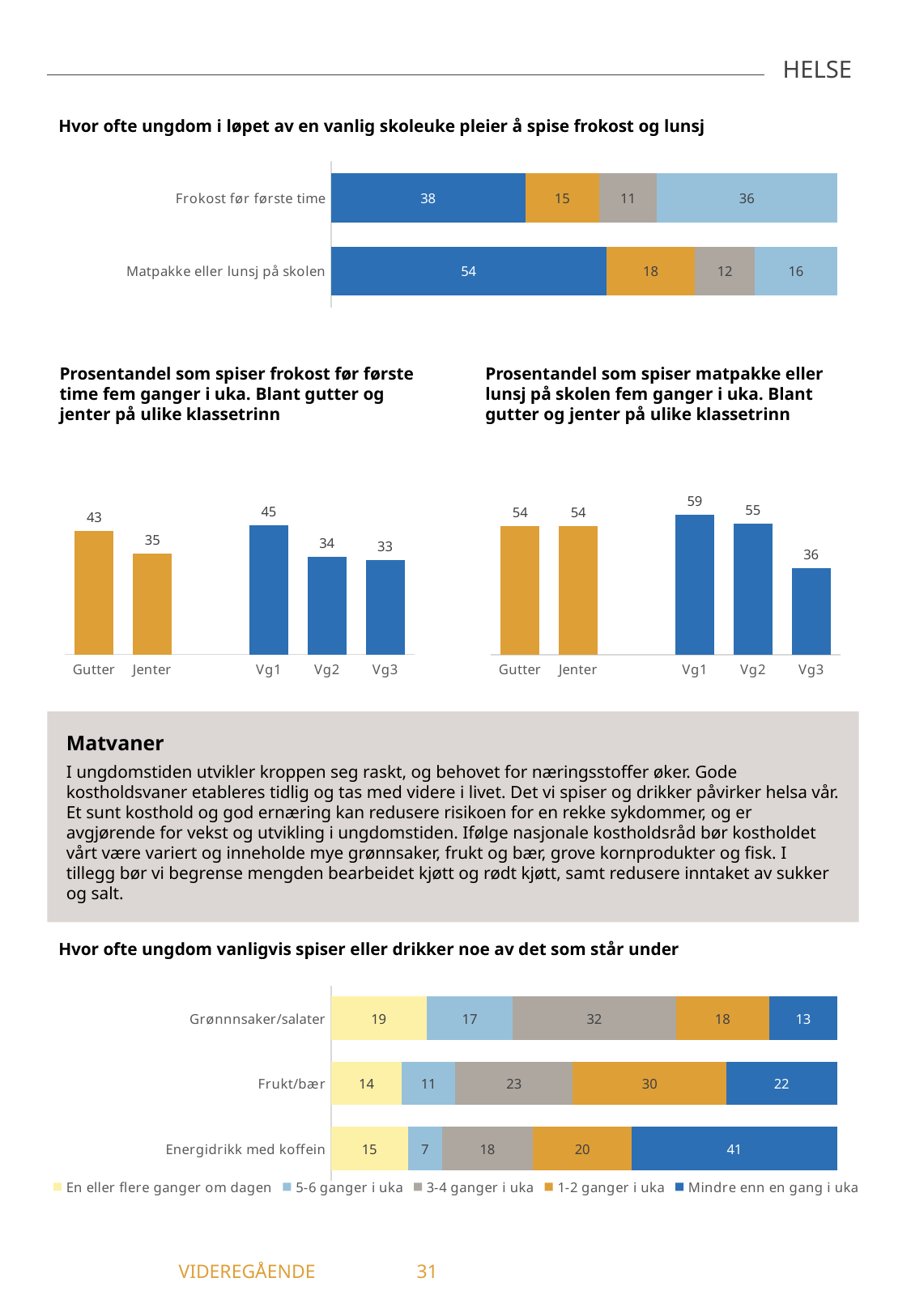
In the chart 'Prosentandel som spiser matpakke eller lunsj på skolen fem ganger i uka', which category has the highest value? Vg1 In the chart 'Prosentandel som spiser frokost før første time fem ganger i uka', which category has the lowest value? Vg3 In the chart 'Hvor ofte ungdom i løpet av en vanlig skoleuke pleier å spise frokost og lunsj', what is the total of all segments for 'Frokost før første time'? 100 In the chart 'Hvor ofte ungdom vanligvis spiser eller drikker noe av det som står under', what is the value for 'Mindre enn en gang i uka' for 'Energidrikk med koffein'? 41 In the chart 'Hvor ofte ungdom i løpet av en vanlig skoleuke pleier å spise frokost og lunsj', how many categories are shown? 2 In the chart 'Prosentandel som spiser frokost før første time fem ganger i uka', what is the difference between Gutter and Jenter? 8 In the chart 'Prosentandel som spiser matpakke eller lunsj på skolen fem ganger i uka', what is the value for Vg3? 36 In the chart 'Prosentandel som spiser matpakke eller lunsj på skolen fem ganger i uka', do the values rise or fall from Vg1 to Vg3? fall In the chart 'Hvor ofte ungdom i løpet av en vanlig skoleuke pleier å spise frokost og lunsj', what is the value of the first (dark blue) segment for 'Matpakke eller lunsj på skolen'? 54 In the chart 'Hvor ofte ungdom vanligvis spiser eller drikker noe av det som står under', which is larger for 'Frukt/bær': '1-2 ganger i uka' or '3-4 ganger i uka'? 1-2 ganger i uka In the chart 'Prosentandel som spiser frokost før første time fem ganger i uka', what is the value for Vg1? 45 In the chart 'Hvor ofte ungdom vanligvis spiser eller drikker noe av det som står under', how many series does the legend list? 5